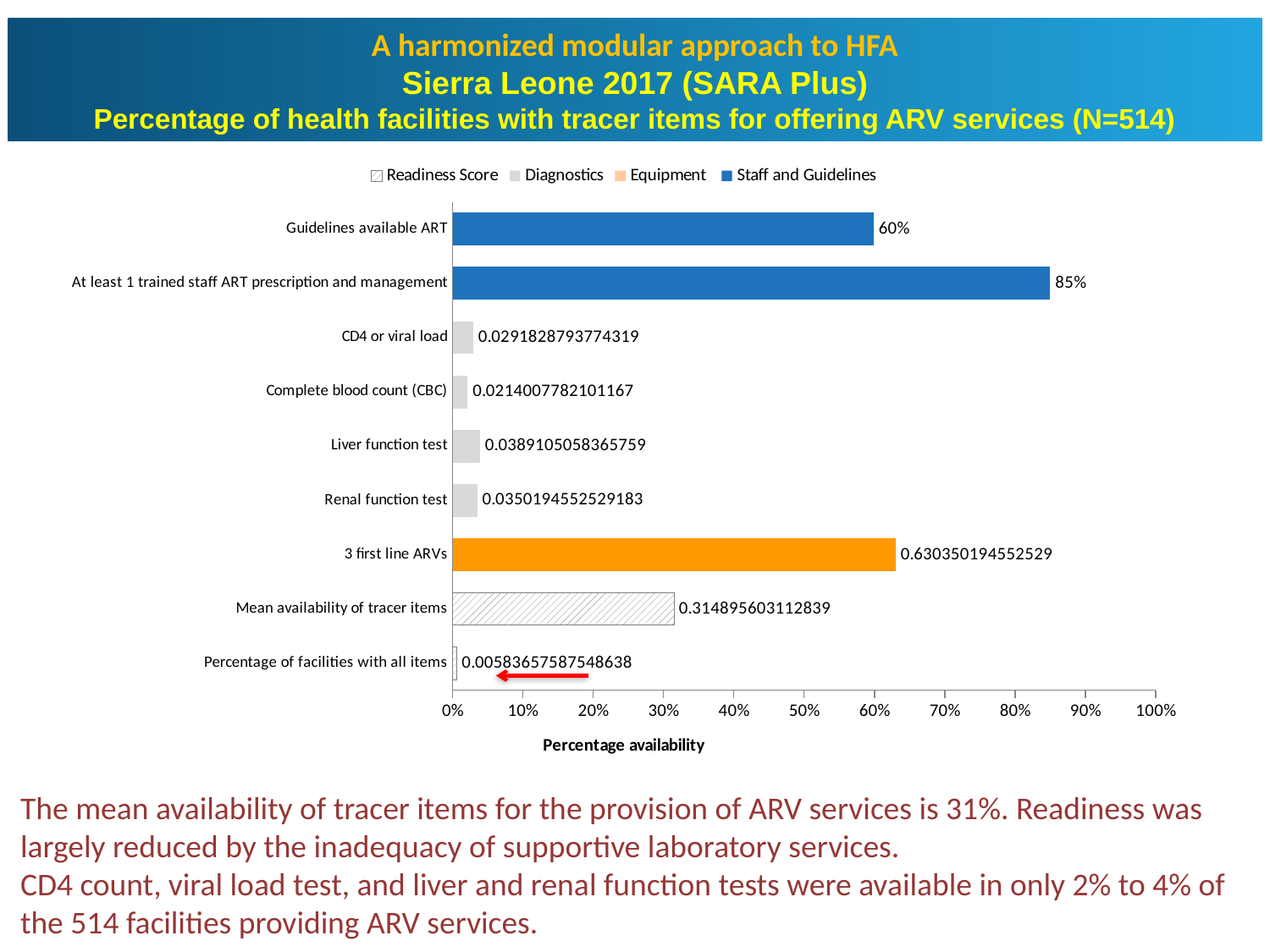
What is the data label shown for '3 first line ARVs'? 0.630350194552529 What kind of chart is shown on the slide? Bar chart How many series does the legend list? 4 Is the value for 'Mean availability of tracer items' greater or less than 30%? greater What is the value shown for 'At least 1 trained staff ART prescription and management'? 85% Which category has the lowest value in the chart? Percentage of facilities with all items What is the data label shown for 'Mean availability of tracer items'? 0.314895603112839 Which has a larger value: 'Liver function test' or 'Renal function test'? Liver function test How many categories are plotted in the chart? 9 What is the difference between the values for 'At least 1 trained staff ART prescription and management' and 'Guidelines available ART'? 25% Which category has the highest value in the chart? At least 1 trained staff ART prescription and management What is the value shown for 'Guidelines available ART'? 60%